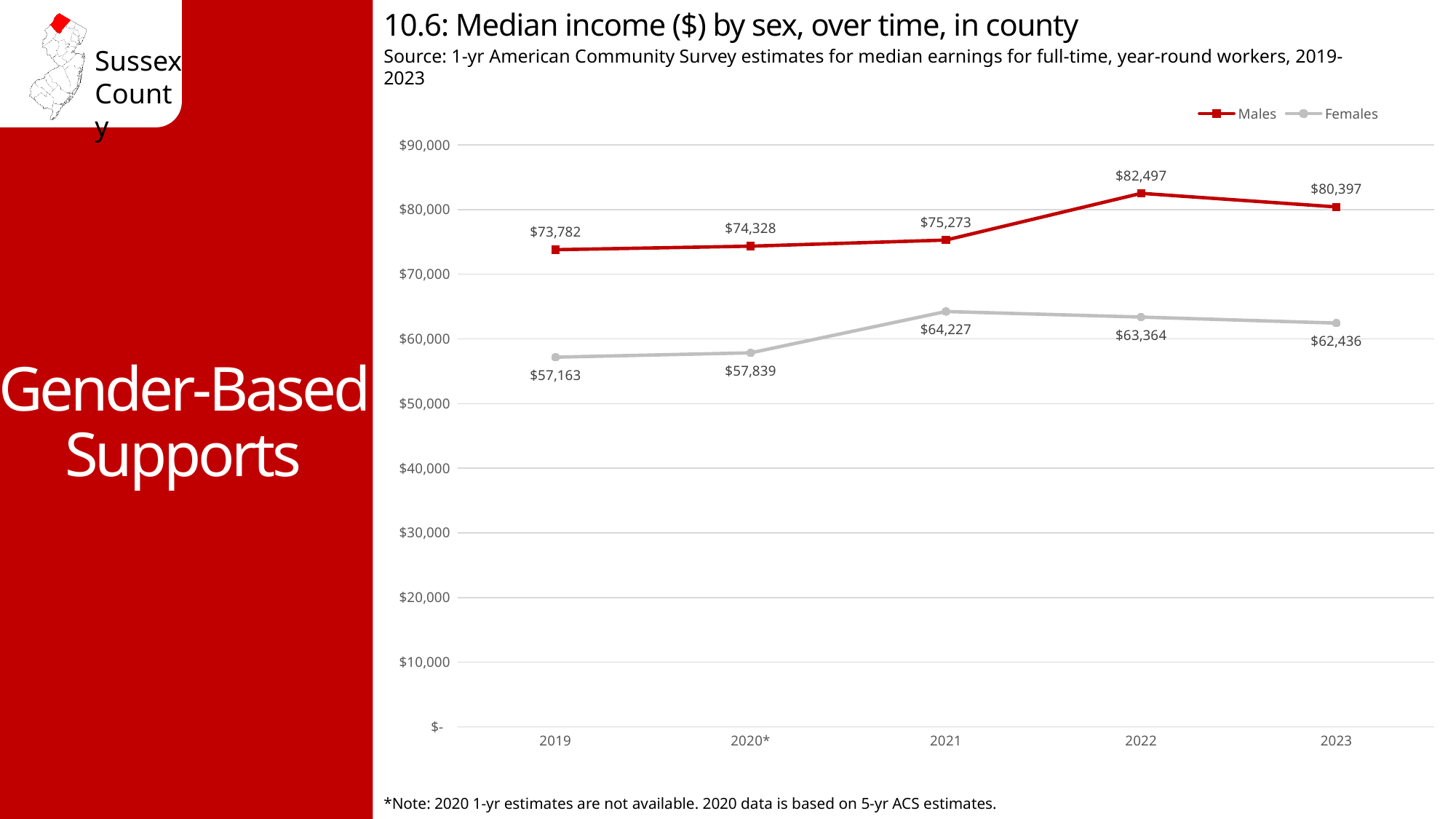
In which year was the median income for Females lowest? 2019 Which was larger in 2020*: the median income for Males or for Females? Males Is the median income for Females in 2022 greater or less than $70,000? less What kind of chart is shown on the slide? line chart What was the median income for Males in 2022? $82,497 How many series does the legend list? 2 What was the median income for Females in 2019? $57,163 What was the median income for Females in 2021? $64,227 In which year was the median income for Males highest? 2022 What is the difference between the Males and Females median income in 2023? $17,961 Did the median income for Males rise or fall from 2022 to 2023? fall How many years are shown on the x axis? 5